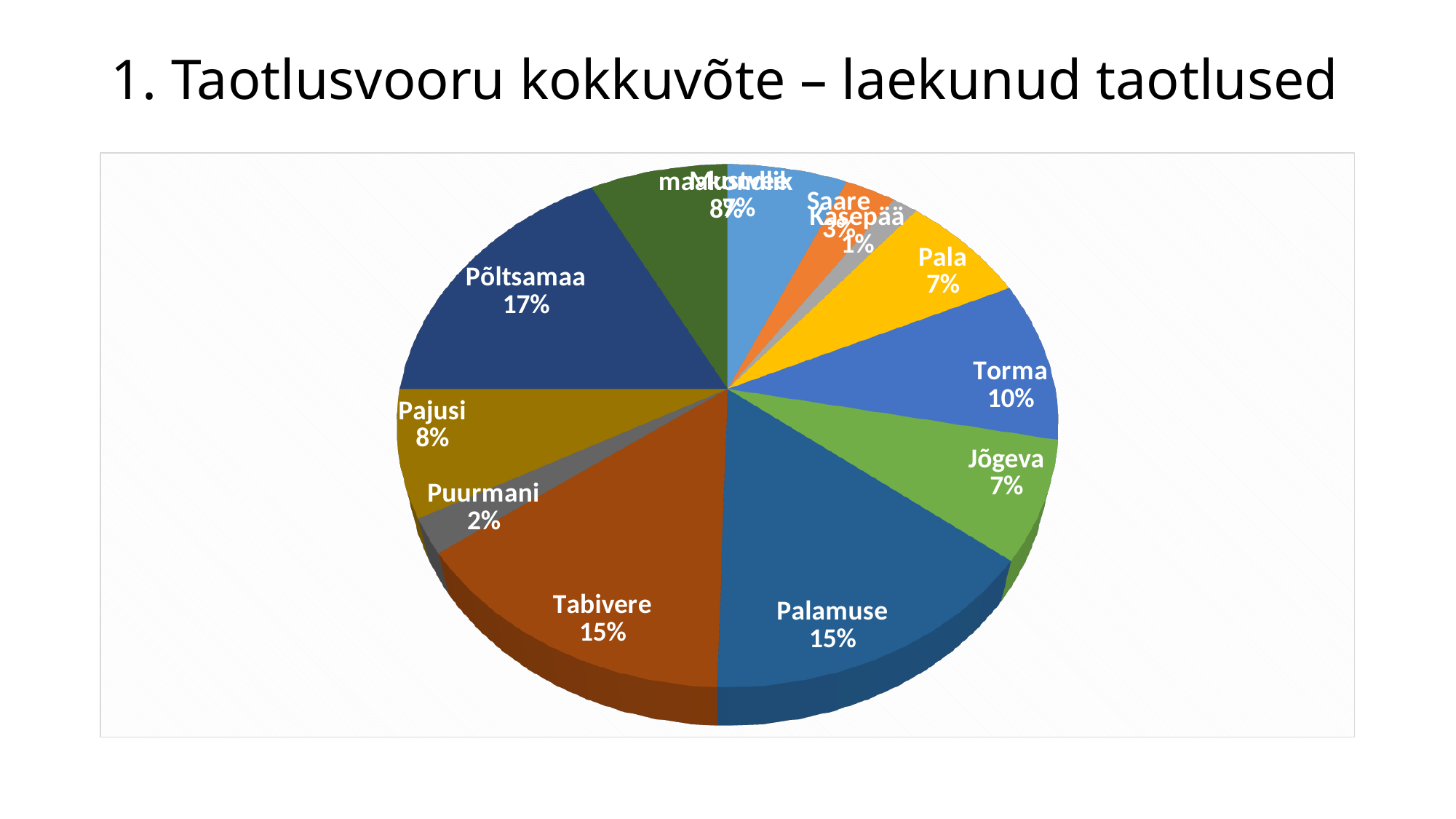
What percentage share does Puurmani have in the pie chart? 2% What percentage share does Põltsamaa have in the pie chart? 17% What percentage share does Kasepää have in the pie chart? 1% What is the combined share of Palamuse and Tabivere? 30% What type of chart is shown on the slide? pie chart What percentage share does Pajusi have in the pie chart? 8% What percentage share does Torma have in the pie chart? 10% Which has a larger share, Torma or Jõgeva? Torma Which category has the smallest slice in the pie chart? Kasepää Which category has the largest slice in the pie chart? Põltsamaa What is the title of the slide? 1. Taotlusvooru kokkuvõte – laekunud taotlused What is the difference in percentage points between Põltsamaa and Torma? 7